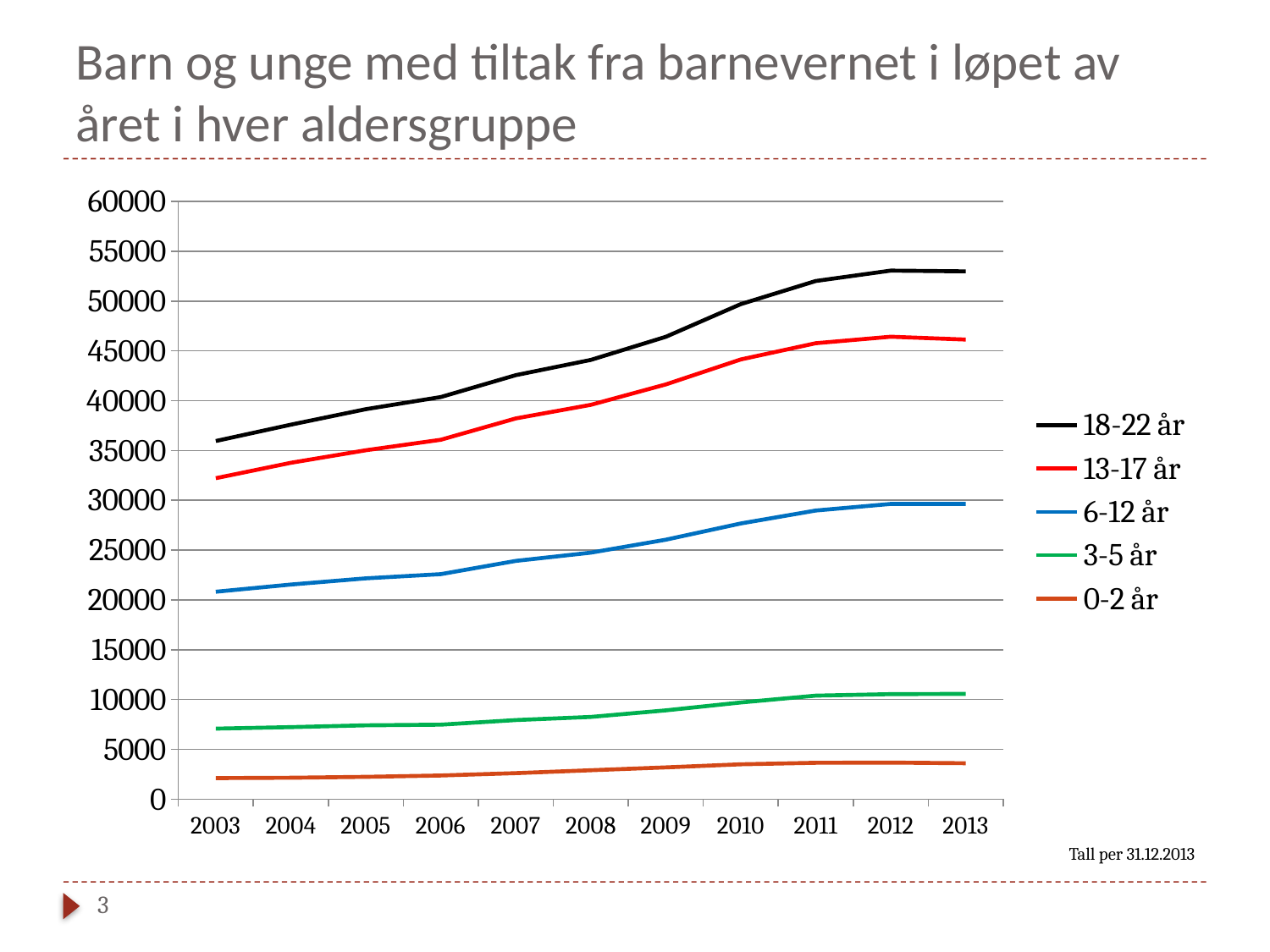
How many years are shown along the x axis? 11 What colour is the line for 18-22 år? black Which age group has the highest values throughout the chart? 18-22 år Is the value for 13-17 år in 2003 greater or less than 35000? less Is the value for 18-22 år in 2013 greater or less than 50000? greater What kind of chart is shown on the slide? line chart Does the value for 18-22 år rise or fall from 2003 to 2012? rise In 2010, which is larger: the value for 13-17 år or the value for 6-12 år? 13-17 år Is the value for 0-2 år in 2013 greater or less than 5000? less How many series does the legend list? 5 Which age group has the lowest values throughout the chart? 0-2 år